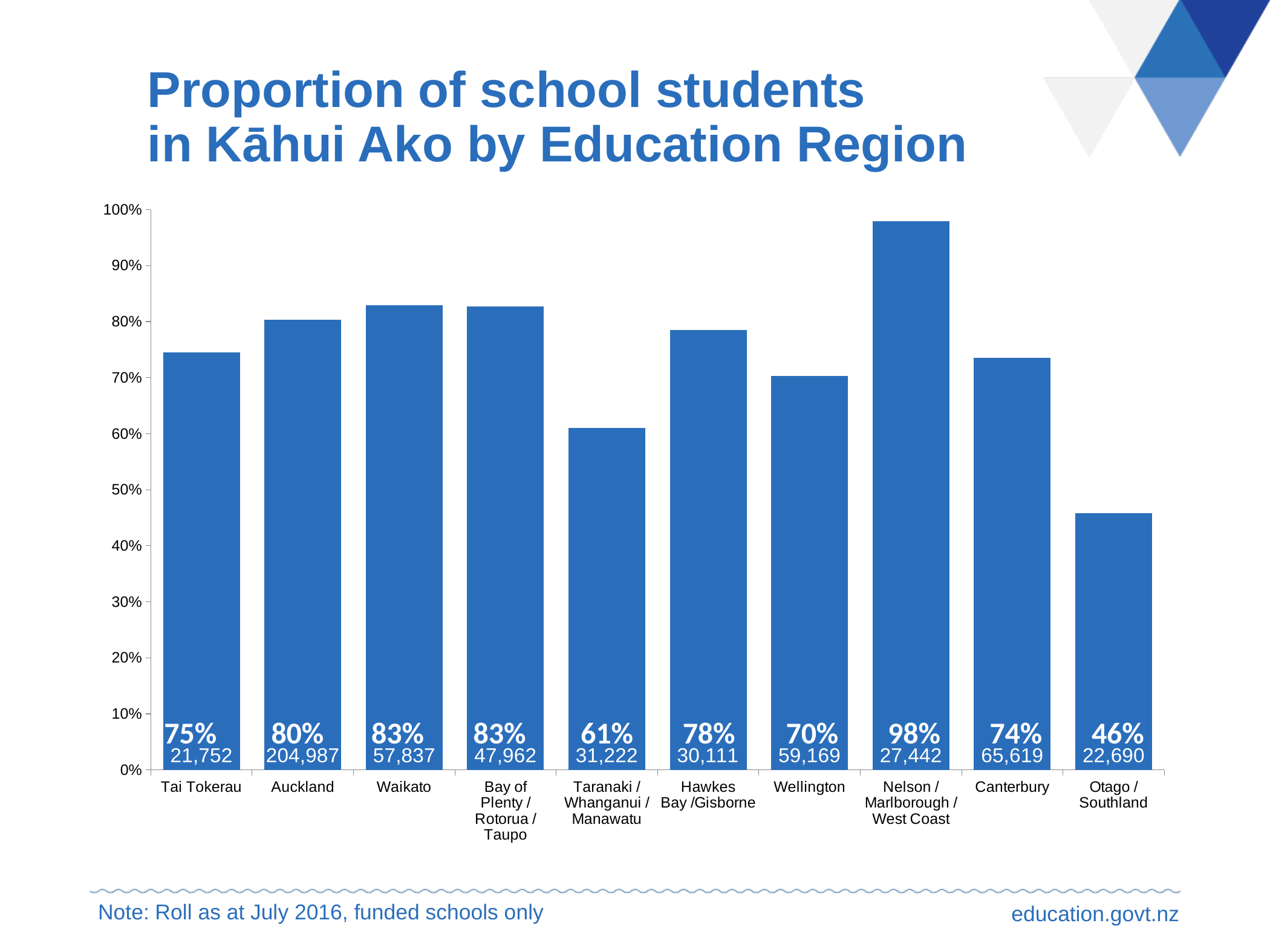
How many education regions are shown on the chart? 10 What kind of chart is shown on the slide? Bar chart Which has a higher proportion of students in Kāhui Ako, Hawkes Bay / Gisborne or Wellington? Hawkes Bay / Gisborne What is the student count shown for Auckland? 204,987 What is the student count shown for Wellington? 59,169 Is the value for Taranaki / Whanganui / Manawatu greater or less than 70%? less What is the title of the chart? Proportion of school students in Kāhui Ako by Education Region What is the difference in percentage points between Nelson / Marlborough / West Coast and Otago / Southland? 52 Which education region has the lowest proportion of school students in Kāhui Ako? Otago / Southland What proportion of school students are in Kāhui Ako in Auckland? 80% Which education region has the highest proportion of school students in Kāhui Ako? Nelson / Marlborough / West Coast What proportion of school students are in Kāhui Ako in Otago / Southland? 46%